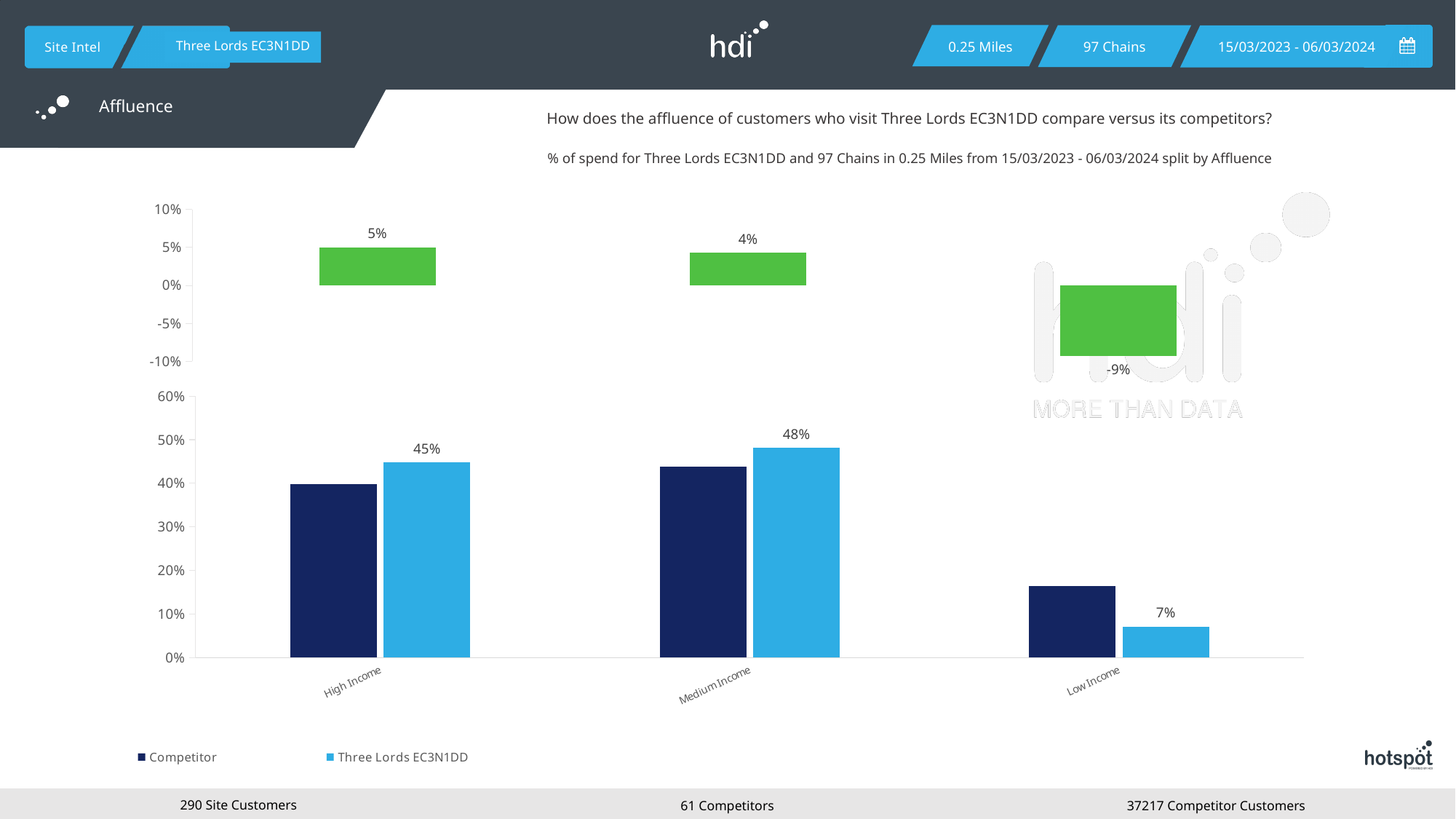
In the bottom chart, what is the value for Three Lords EC3N1DD in the High Income category? 45% In the bottom chart, what is the value for Three Lords EC3N1DD in the Medium Income category? 48% In the bottom chart, which category has the lowest value for Three Lords EC3N1DD? Low Income In the top chart, what is the value shown for the High Income category? 5% In the bottom chart, is the Competitor value for Low Income greater or less than 20%? less In the top chart, what is the value shown for the Low Income category? -9% In the bottom chart, what is the difference between the Three Lords EC3N1DD values for Medium Income and Low Income? 41% How many series does the legend of the bottom chart list? 2 In the bottom chart, what is the value for Three Lords EC3N1DD in the Low Income category? 7% In the bottom chart, which category has the highest value for Three Lords EC3N1DD? Medium Income In the bottom chart, which is larger for Low Income: the Competitor value or the Three Lords EC3N1DD value? Competitor What type of chart is the bottom chart? Bar chart